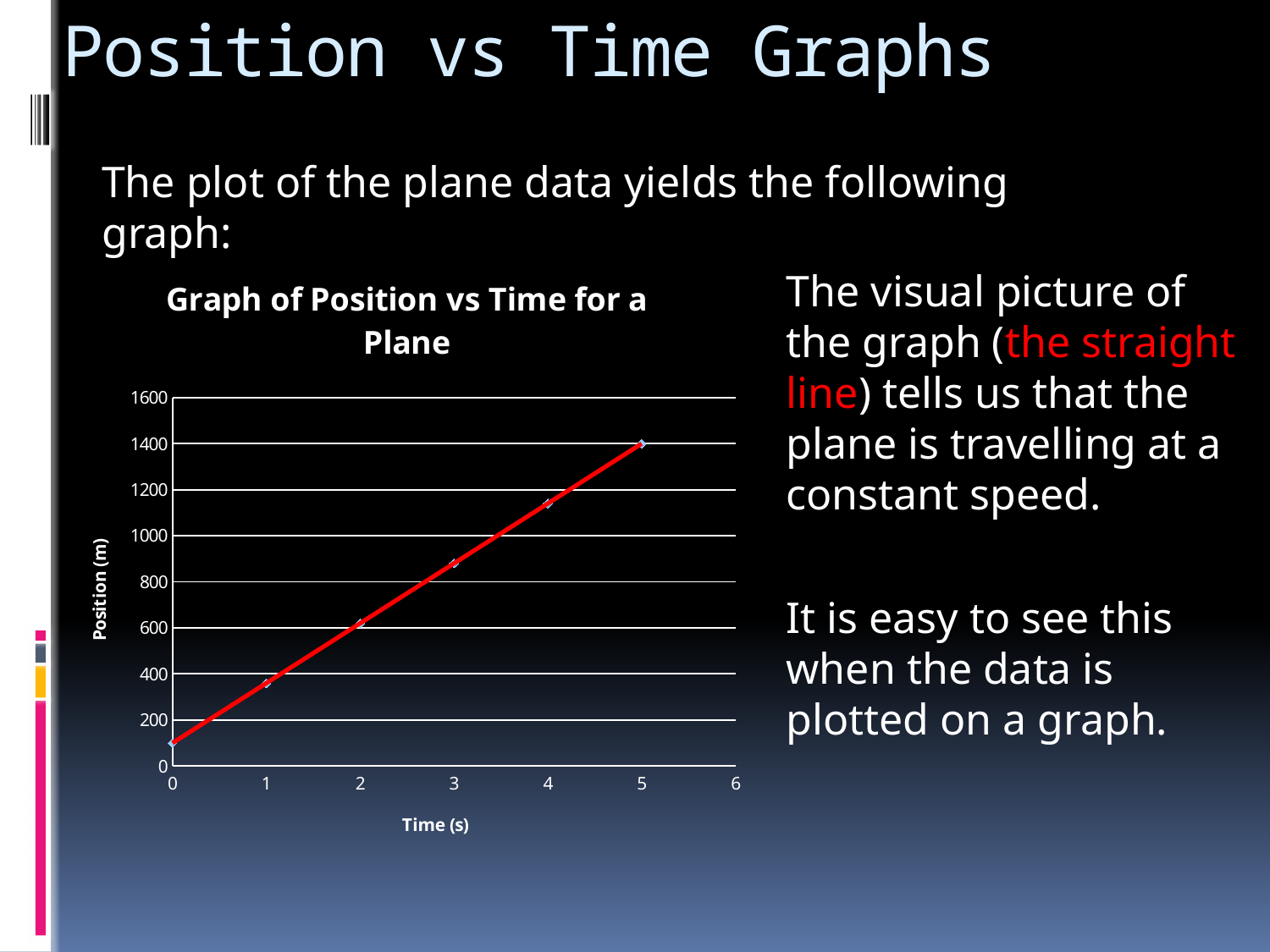
Is the position at time 4 s greater or less than 1200? less What is the title of the chart? Graph of Position vs Time for a Plane At which time (s) is the plotted position highest? 5 How many data points are plotted on the line? 6 Is the position at time 2 s greater or less than 800? less Is the position at time 1 s greater or less than 400? less What kind of chart is shown on the slide? Line chart At which time (s) is the plotted position lowest? 0 Which is larger, the position at time 4 s or the position at time 2 s? Time 4 s What colour is the plotted line in the chart? Red Does the position rise or fall as time increases along the x axis? Rise